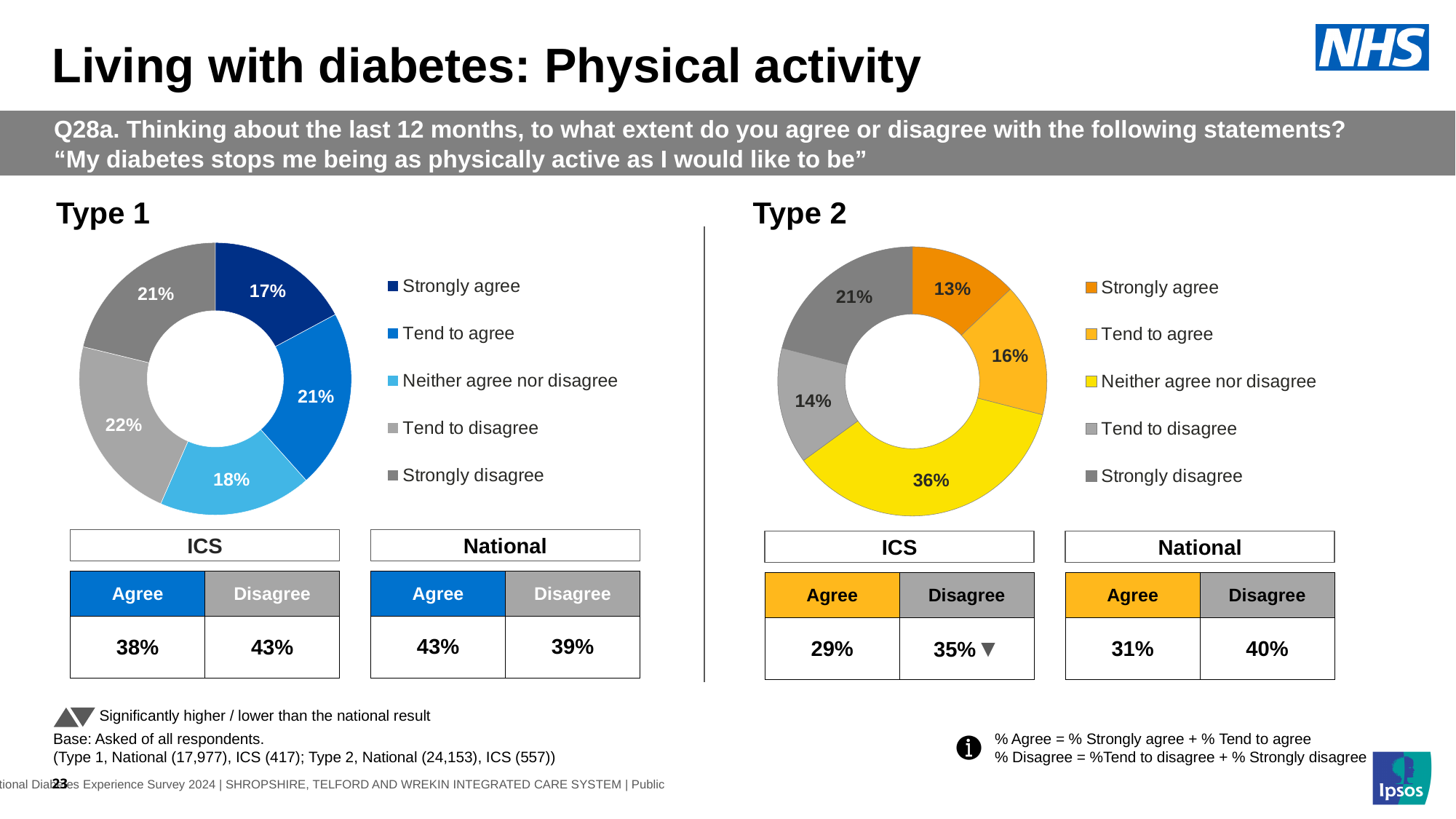
In the Type 2 chart, what percentage of respondents said 'Tend to agree'? 16% Which is larger in the Type 2 chart: 'Strongly disagree' or 'Tend to disagree'? Strongly disagree In the Type 2 chart, what colour is the 'Neither agree nor disagree' segment? Yellow In the Type 2 chart, what percentage of respondents said 'Neither agree nor disagree'? 36% In the Type 1 chart, what percentage of respondents said 'Strongly agree'? 17% How many entries does the legend of the Type 2 chart list? 5 What type of chart is used for the Type 1 results? Pie chart (donut) In the Type 2 chart, which response category has the smallest share? Strongly agree In the Type 2 chart, which response category has the largest share? Neither agree nor disagree In the Type 1 chart, what is the difference between the 'Tend to agree' and 'Strongly agree' shares? 4% In the Type 1 chart, what percentage of respondents said 'Tend to disagree'? 22% How many response categories does the Type 1 chart show? 5